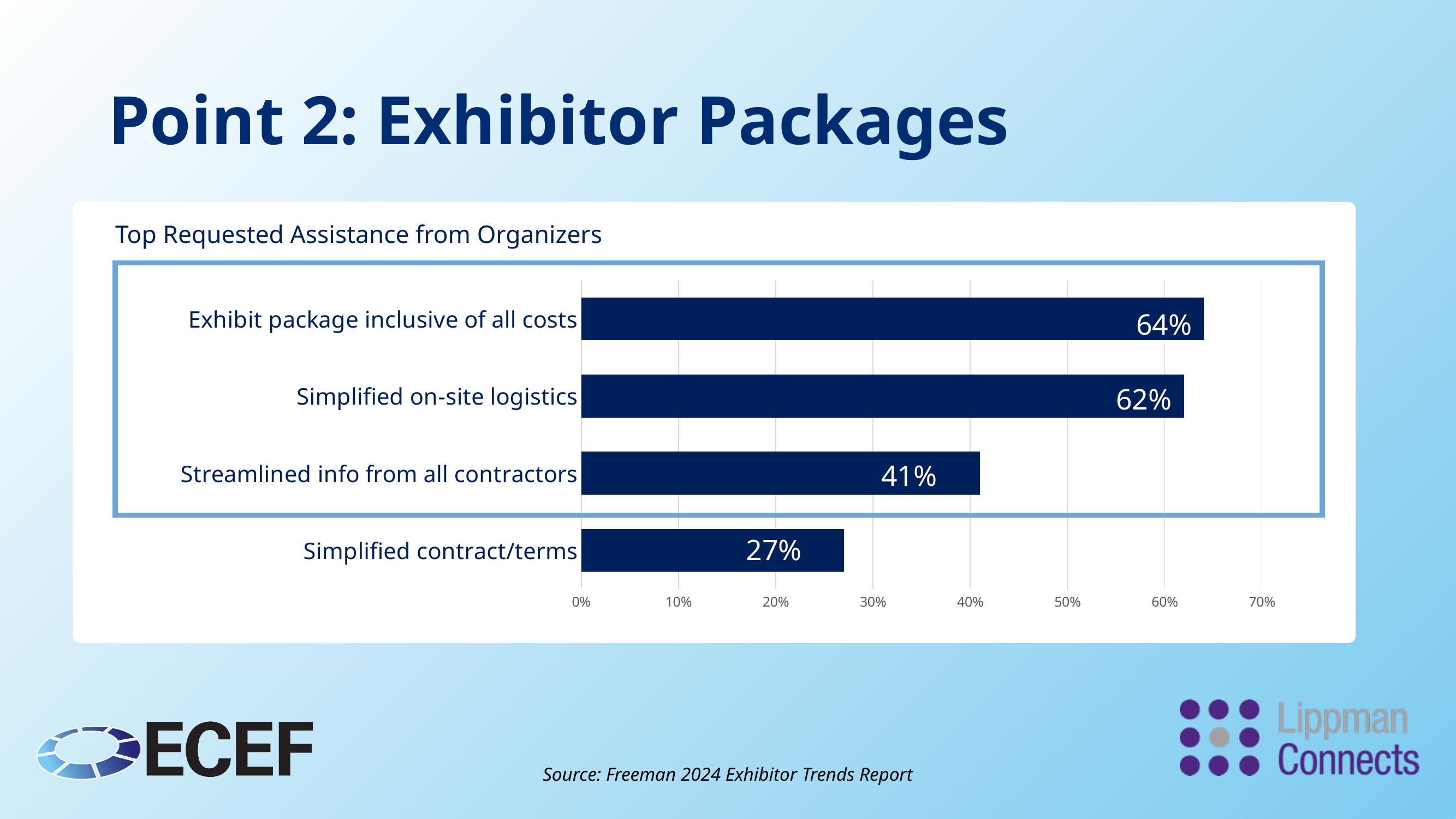
How many categories are shown in the chart? 4 What is the value for Simplified contract/terms? 27% What is the value for Exhibit package inclusive of all costs? 64% What is the value for Simplified on-site logistics? 62% Which category has the highest value? Exhibit package inclusive of all costs What is the value for Streamlined info from all contractors? 41% Which is larger, the value for Streamlined info from all contractors or the value for Simplified contract/terms? Streamlined info from all contractors What kind of chart is shown on the slide? Bar chart Which category has the lowest value? Simplified contract/terms What is the difference between the values for Simplified on-site logistics and Streamlined info from all contractors? 21% What is the difference between the values for Exhibit package inclusive of all costs and Simplified contract/terms? 37% What is the title of the chart? Top Requested Assistance from Organizers